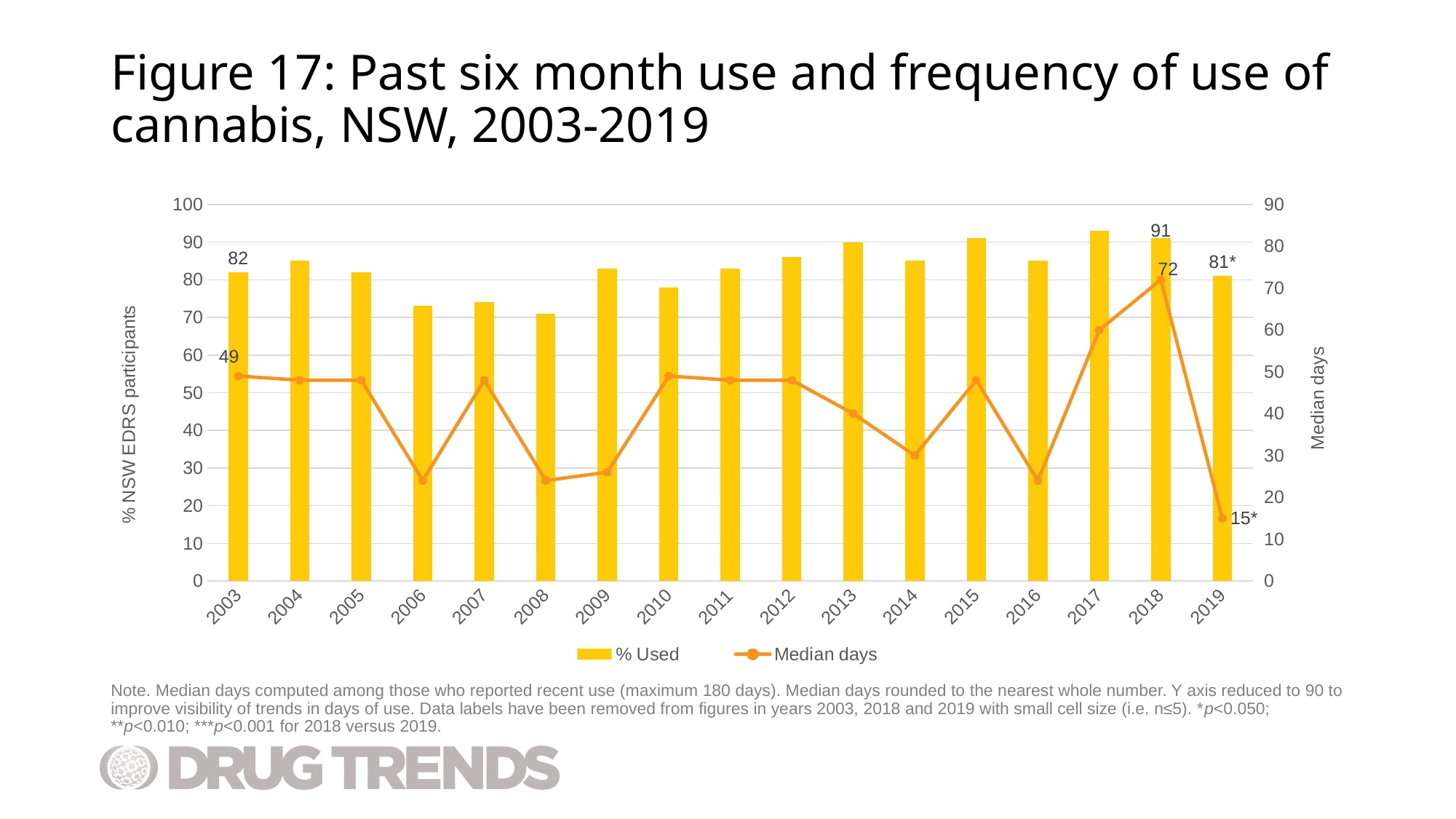
In which year is the Median days value lowest? 2019 Which year has the higher Median days value, 2003 or 2018? 2018 In which year is the Median days value highest? 2018 Is the % Used value for 2006 greater or less than 80? less How many series does the legend list? 2 How many years are shown on the x axis? 17 What is the Median days value for 2003? 49 What is the % Used value for 2003? 82 What is the difference between the Median days values for 2018 and 2019? 57 What is the % Used value for 2018? 91 What is the Median days value for 2019? 15* What is the difference between the % Used values for 2018 and 2019? 10